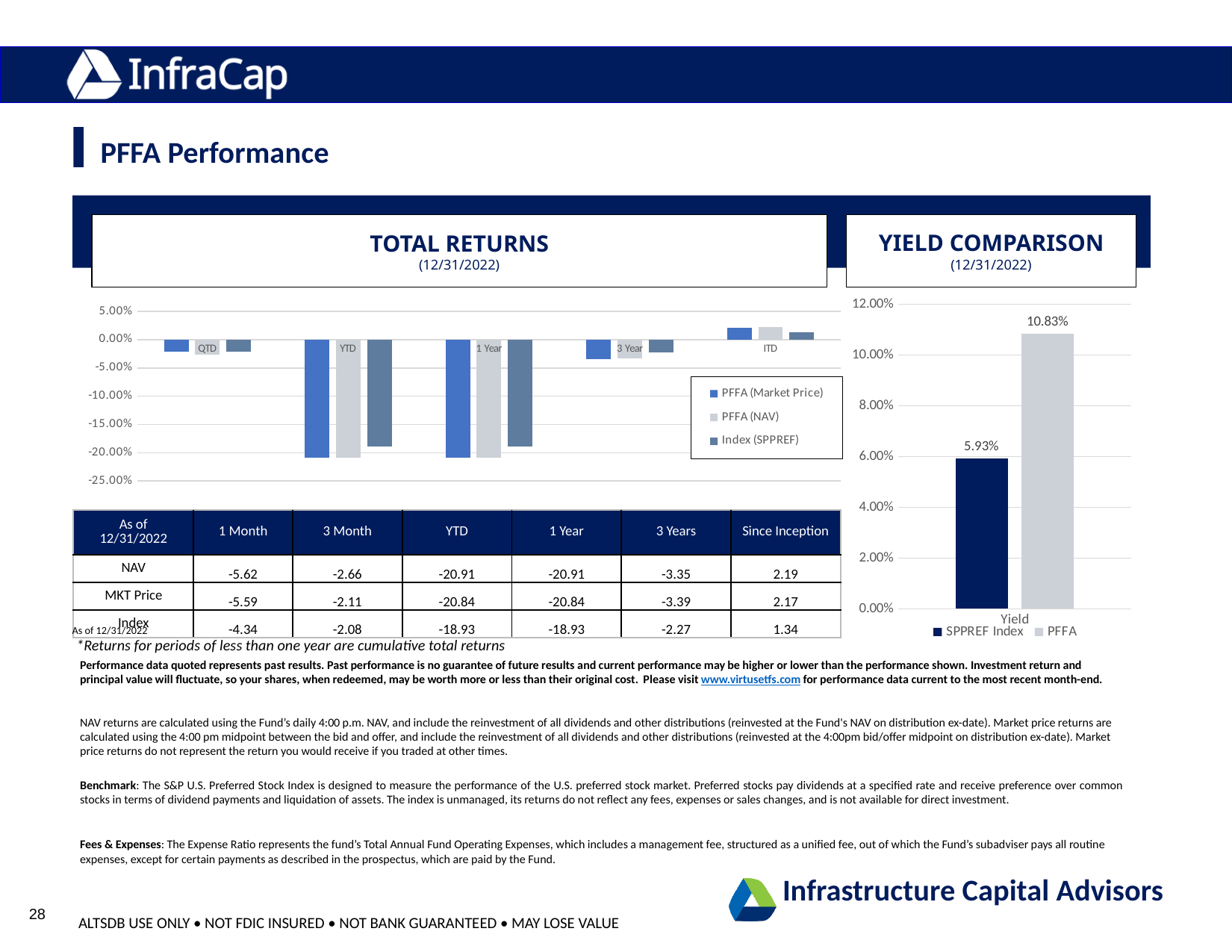
What date is shown in the subtitle of the Total Returns chart? 12/31/2022 In the Total Returns chart, is the YTD value for PFFA (Market Price) greater or less than -15.00%? less In the Yield Comparison chart, what is the yield shown for PFFA? 10.83% What kind of chart is the Yield Comparison chart? Bar chart In the Yield Comparison chart, which series has the higher yield? PFFA In the Total Returns chart, how many series does the legend list? 3 In the Yield Comparison chart, how many series does the legend list? 2 In the Yield Comparison chart, what is the difference between the PFFA yield and the SPPREF Index yield? 4.90% In the Total Returns chart, how many period categories are shown on the x axis? 5 In the Total Returns chart, for the YTD period, which is lower: PFFA (Market Price) or Index (SPPREF)? PFFA (Market Price) In the Total Returns chart, is the ITD value for PFFA (NAV) greater or less than 5.00%? less In the Yield Comparison chart, what is the yield shown for the SPPREF Index? 5.93%